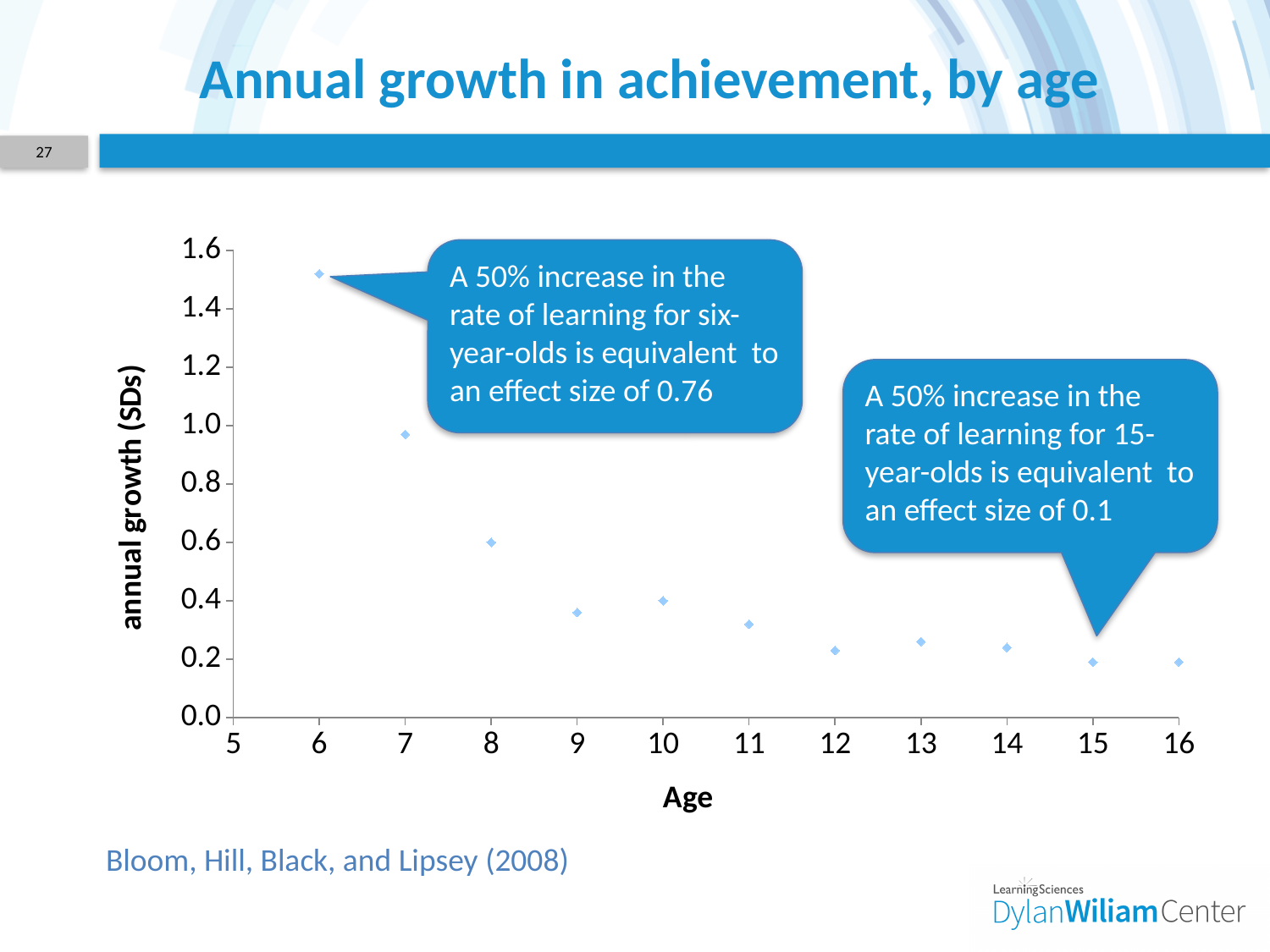
Is the value for age 12 greater or less than 0.4? less At which age is annual growth in achievement highest? 6 What is the label on the vertical axis of the chart? annual growth (SDs) Is the value for age 6 greater or less than 1.4? greater Do the values generally rise or fall as age increases? fall How many data points are plotted on the chart? 11 Is the value for age 7 greater or less than 1.0? less Which has the larger annual growth, age 6 or age 7? age 6 What is the title of the chart on the slide? Annual growth in achievement, by age What kind of chart is shown on the slide? scatter chart Which has the larger annual growth, age 8 or age 9? age 8